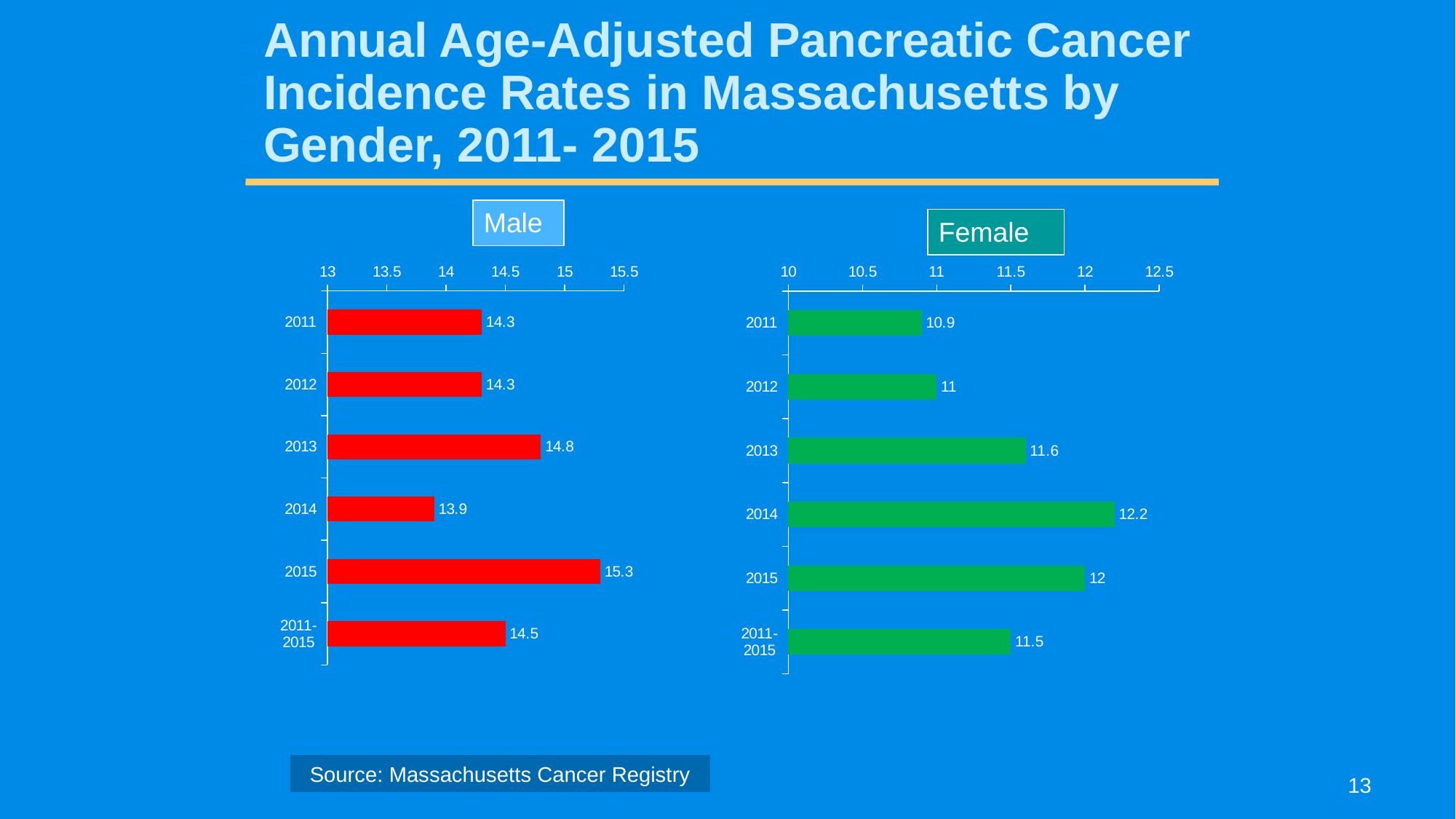
In the Male chart, which year has the highest value? 2015 How many bars are shown in the Male chart? 6 In the Male chart, what is the difference between the 2015 value and the 2014 value? 1.4 What kind of chart is the Female chart? Bar chart In the Female chart, which is larger, the value for 2013 or the value for 2015? 2015 In the Female chart, what is the difference between the 2014 value and the 2011 value? 1.3 In the Female chart, which year has the highest value? 2014 In the Male chart, what is the value for 2011-2015? 14.5 In the Female chart, what is the value for 2011? 10.9 In the Male chart, which year has the lowest value? 2014 In the Male chart, what is the value for 2015? 15.3 In the Female chart, what is the value for 2014? 12.2